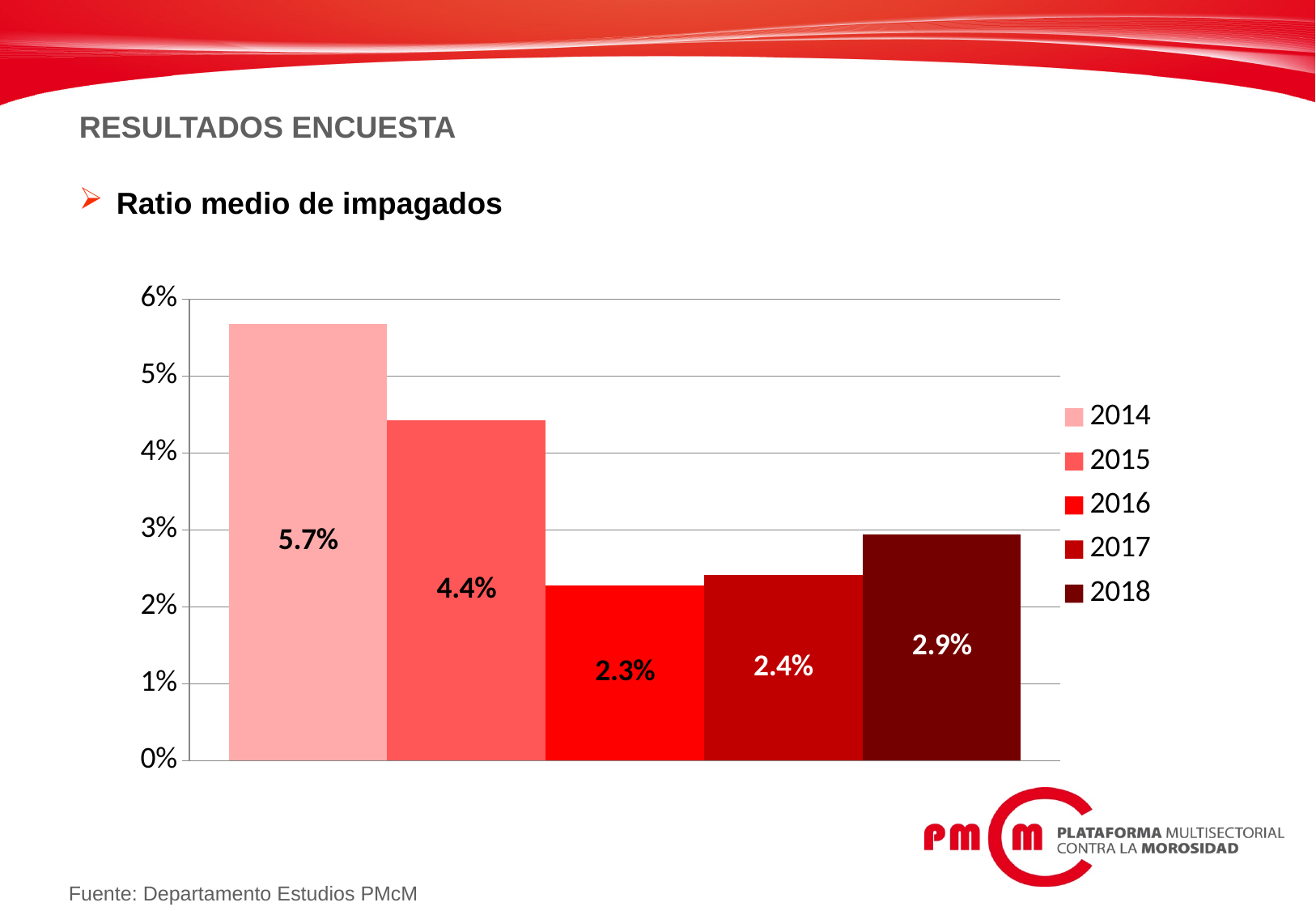
How many entries does the legend list? 5 What is the difference between the values for 2018 and 2017? 0.5% Which is larger, the value for 2015 or the value for 2018? 2015 Which year has the lowest value? 2016 Which year has the highest value? 2014 What is the value for 2018? 2.9% What is the value for 2014? 5.7% What is the value for 2016? 2.3% What is the difference between the values for 2014 and 2015? 1.3% What kind of chart is shown on the slide? bar chart How many years are plotted in the chart? 5 Is the value for 2015 greater or less than 4%? greater